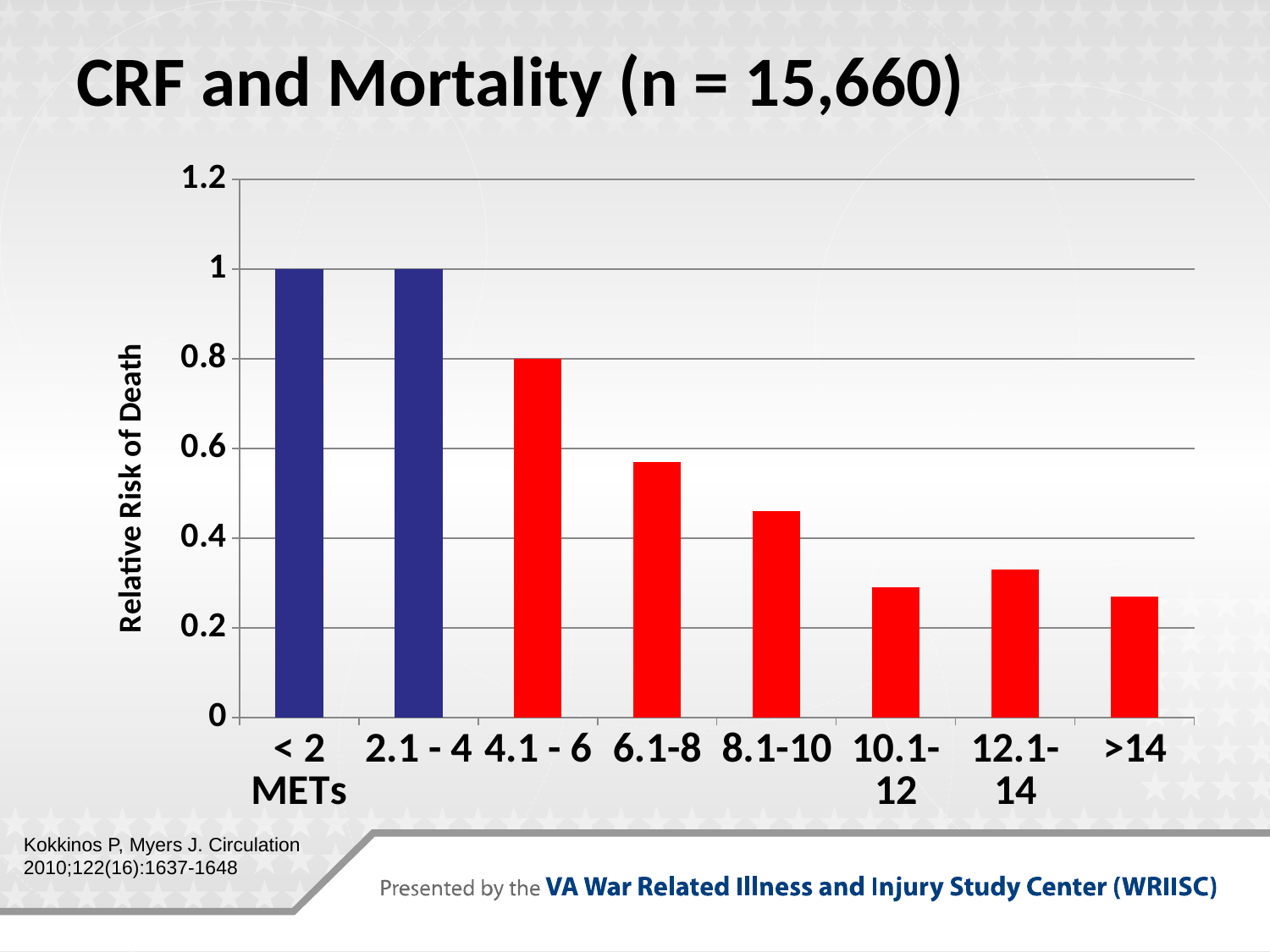
What colour are the bars for the two lowest MET categories? blue Is the value for the 6.1-8 category greater or less than 0.6? less What is the title of the chart's y axis? Relative Risk of Death Which has a higher relative risk of death, the 6.1-8 category or the 8.1-10 category? 6.1-8 Do the values generally rise or fall as METs increase along the x axis? fall Is the value for the >14 category greater or less than 0.2? greater What is the relative risk of death for the 2.1 - 4 METs category? 1 How many MET categories are shown on the x axis? 8 What is the relative risk of death for the 4.1 - 6 METs category? 0.8 What kind of chart is shown on the slide? bar chart Is the value for the 8.1-10 category greater or less than 0.4? greater What is the relative risk of death for the < 2 METs category? 1